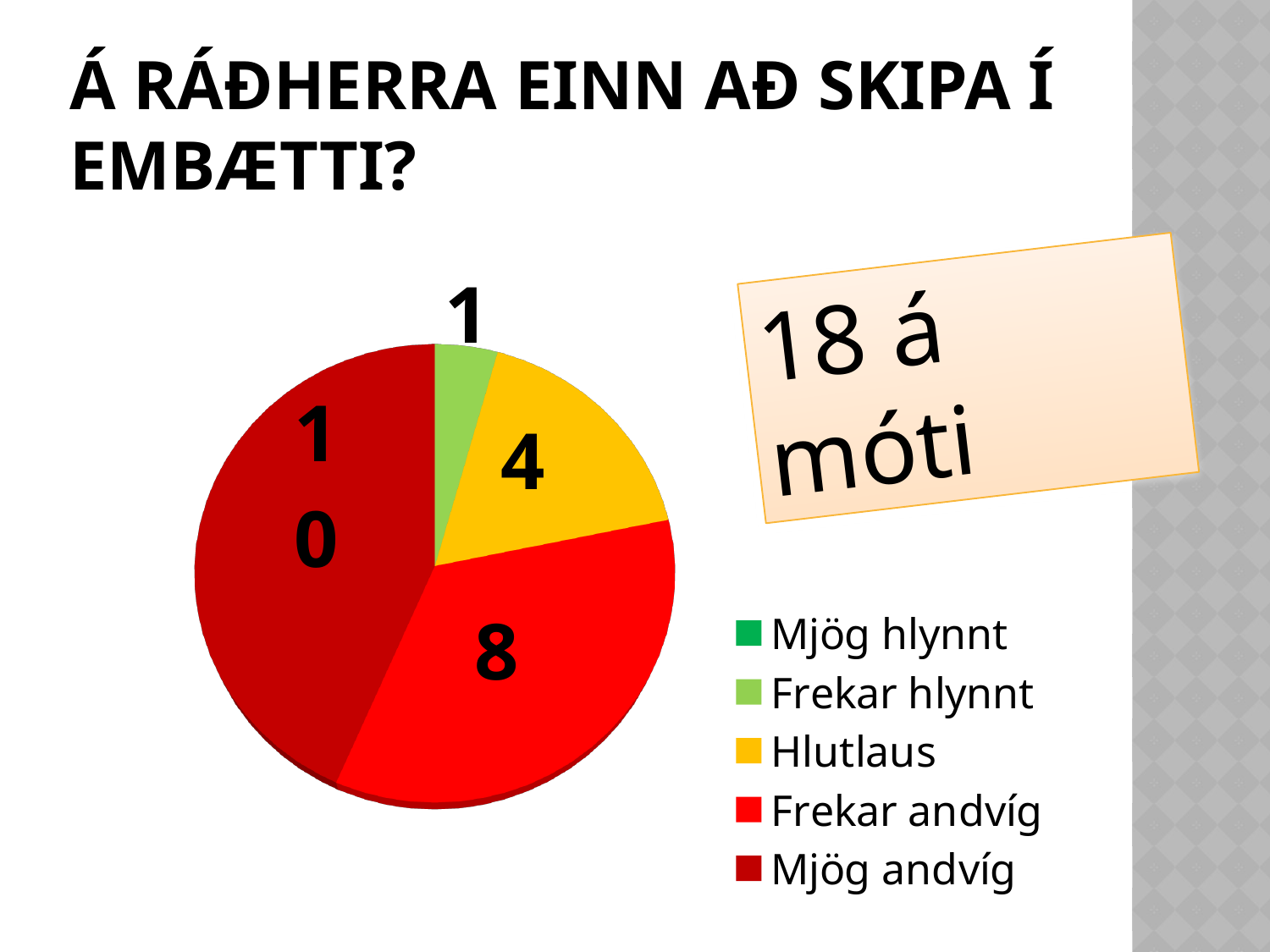
Which is larger, the Hlutlaus slice or the Frekar hlynnt slice? Hlutlaus What value is shown for the Hlutlaus slice? 4 Which labelled slice has the smallest value? Frekar hlynnt How many entries does the legend list? 5 Which category has the largest slice of the pie? Mjög andvíg What value is shown for the Frekar hlynnt slice? 1 What value is shown for the Frekar andvíg slice? 8 What value is shown for the Mjög andvíg slice? 10 What kind of chart is shown on the slide? pie chart What colour is the Hlutlaus slice? yellow What is the difference between the Frekar andvíg value and the Hlutlaus value? 4 What is the difference between the Mjög andvíg value and the Frekar andvíg value? 2